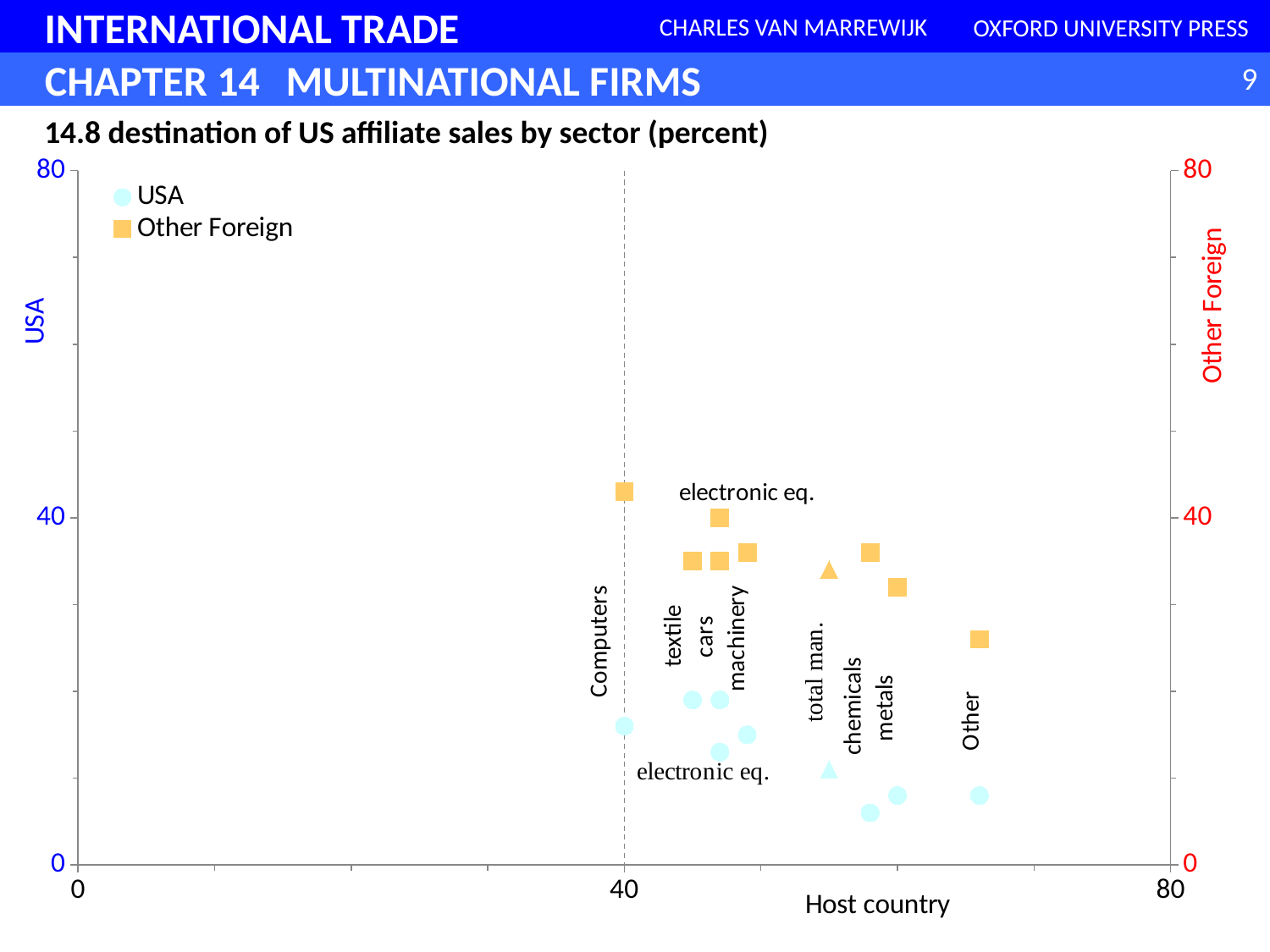
Is the Other Foreign value for Computers greater or less than 40? greater What kind of chart is shown on the slide? scatter chart Is the USA value for Computers greater or less than 40? less How many series does the legend list? 2 Which is larger for Computers, the USA value or the Other Foreign value? Other Foreign What is the label of the horizontal axis? Host country Do the USA values generally rise or fall as the Host country value increases along the x axis? fall How many sectors are labelled in the chart? 9 What is the title of the chart? 14.8 destination of US affiliate sales by sector (percent) Which sector has the larger Other Foreign value, Computers or Other? Computers Is the Other Foreign value for Other greater or less than 40? less